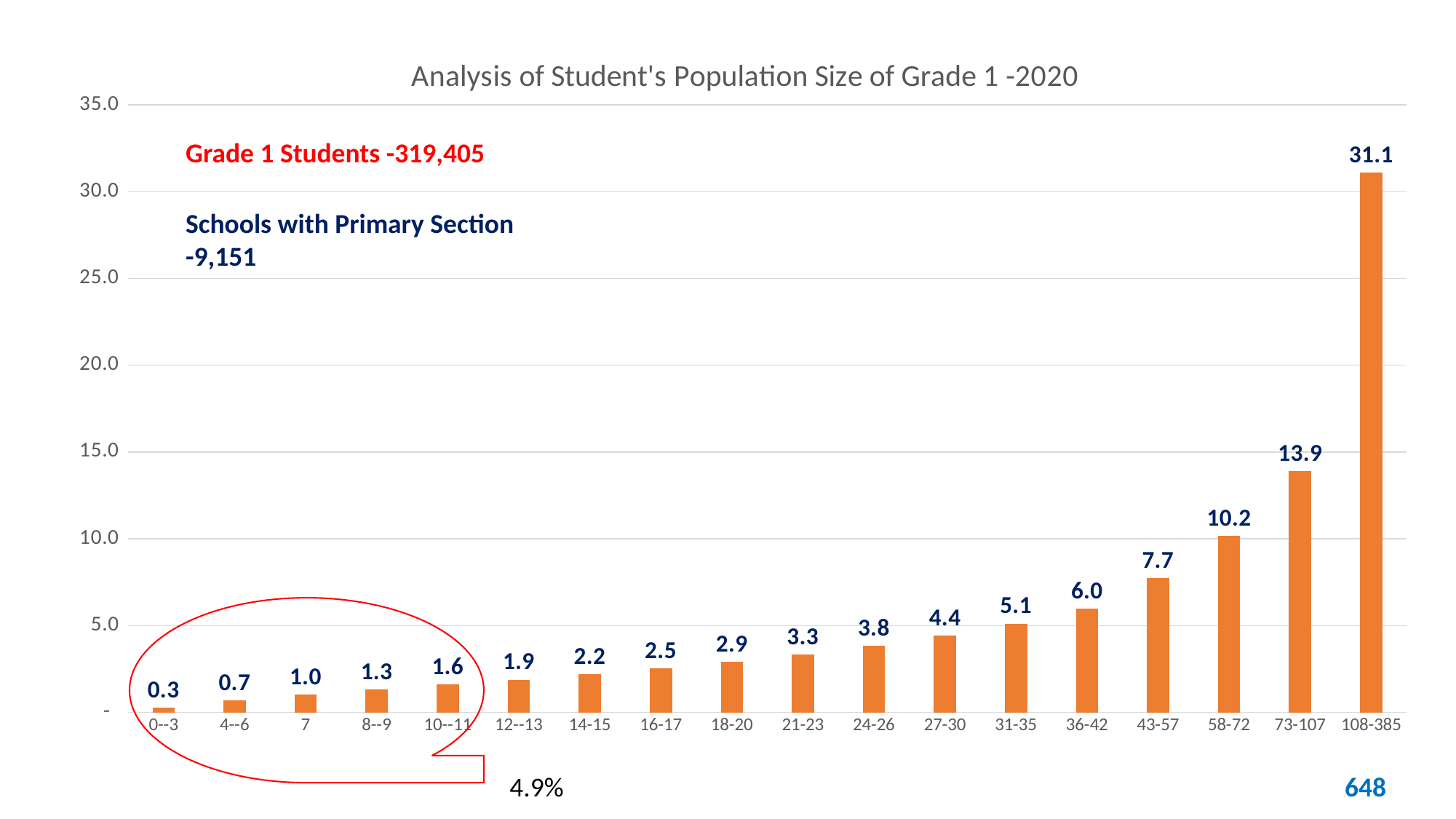
Which category has the lowest value? 0--3 What is the value for the 108-385 category? 31.1 Is the value for 73-107 greater or less than 10.0? greater What is the value for the 18-20 category? 2.9 What is the difference between the values for 58-72 and 36-42? 4.2 What is the difference between the values for 108-385 and 73-107? 17.2 What kind of chart is shown on the slide? Bar chart Do the values rise or fall from left to right along the x axis? Rise Which category has the highest value? 108-385 How many categories are shown on the x axis? 18 Which is larger, the value for 31-35 or the value for 24-26? 31-35 What is the value for the 43-57 category? 7.7